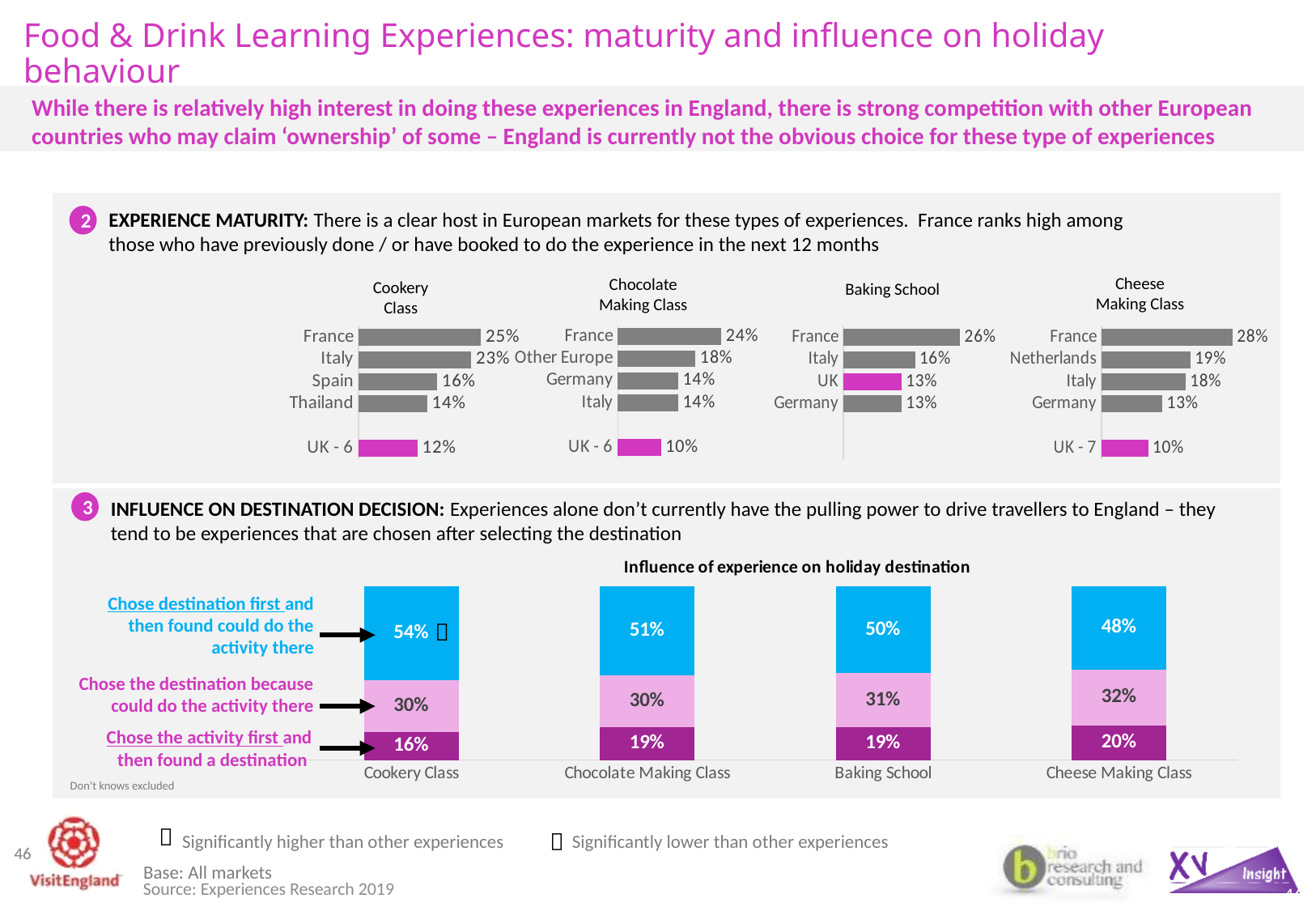
In the Influence of experience on holiday destination chart, what is the difference between the 'Chose the destination because could do the activity there' values for Cheese Making Class and Cookery Class? 2% In the Influence of experience on holiday destination chart, what is the total of the stacked bar for Cheese Making Class? 100% In the Baking School chart, what is the difference between France and Italy? 10% In the Cheese Making Class chart, which country has the highest value? France In the Cheese Making Class chart, what is the value for the Netherlands? 19% How many categories are shown in the Baking School chart? 4 In the Influence of experience on holiday destination chart, which experience has the highest value for 'Chose destination first and then found could do the activity there'? Cookery Class In the Chocolate Making Class chart, what is the value for Other Europe? 18% In the Cookery Class chart, which is larger, Italy or Spain? Italy What kind of chart is the Influence of experience on holiday destination chart? Stacked bar chart In the Cookery Class chart, what is the value for France? 25% In the Influence of experience on holiday destination chart, what share of Cookery Class respondents chose the activity first and then found a destination? 16%